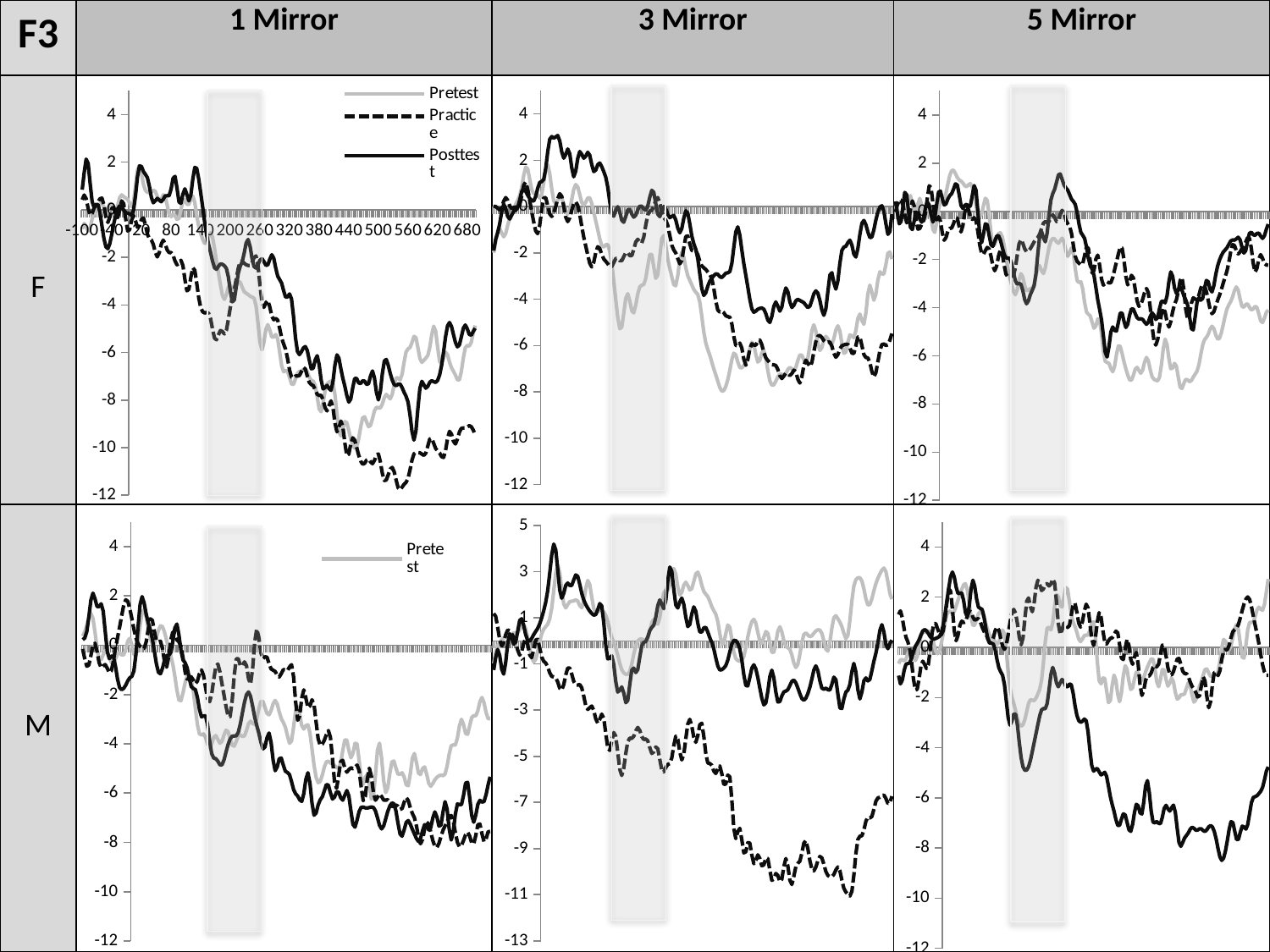
How many series does the legend in the F / 1 Mirror chart list? 3 In the M / 5 Mirror chart, does the Posttest (solid black) line overall rise or fall from left to right? fall In the F / 5 Mirror chart, which line reaches a lower value, Pretest or Posttest? Pretest In the F / 1 Mirror chart, is the lowest point of the Practice (dashed) line greater or less than -10? less In the M / 3 Mirror chart, is the lowest point of the Practice (dashed) line greater or less than -9? less What are the three column headings above the charts on the slide? 1 Mirror, 3 Mirror, 5 Mirror What kind of chart is used in each panel of the F3 grid? Line chart How many separate line charts are shown on the slide? 6 In the M / 5 Mirror chart, is the lowest point of the Posttest (solid black) line greater or less than -6? less In the M / 3 Mirror chart, which line reaches a lower value, Practice or Posttest? Practice What are the three series named in the legend of the F / 1 Mirror chart? Pretest, Practice, Posttest